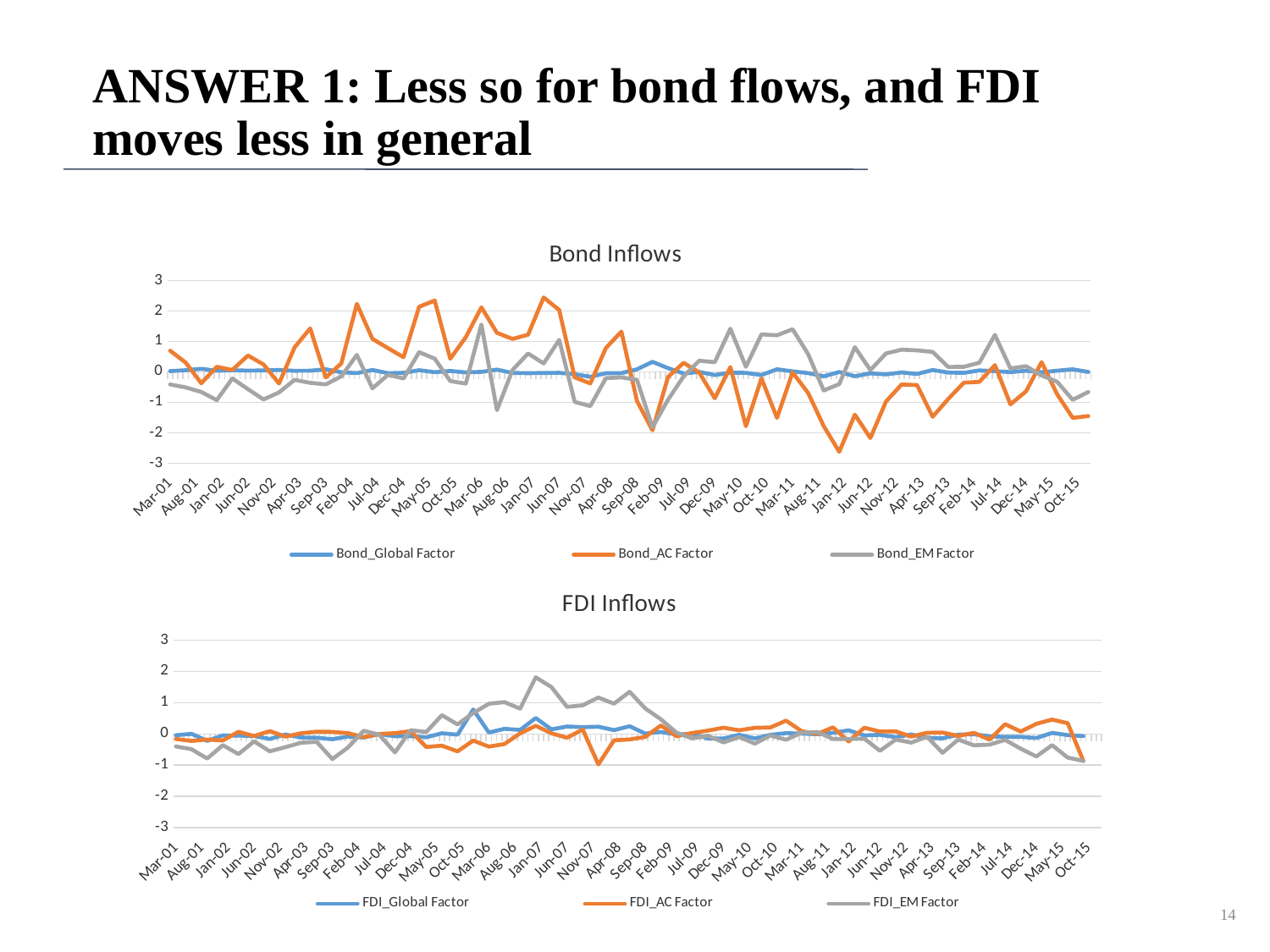
In the Bond Inflows chart, at Jan-12, which is larger: Bond_Global Factor or Bond_AC Factor? Bond_Global Factor In the FDI Inflows chart, is the value of FDI_EM Factor at Jan-07 greater or less than 1? greater In the FDI Inflows chart, which series reaches the highest value anywhere on the chart? FDI_EM Factor How many series does the legend of the FDI Inflows chart list? 3 What is the first date label on the x axis of the FDI Inflows chart? Mar-01 In the Bond Inflows chart, what colour is the Bond_EM Factor line? Grey In the Bond Inflows chart, is the value of Bond_AC Factor at Jan-12 greater or less than -2? less What are the three series named in the legend of the Bond Inflows chart? Bond_Global Factor, Bond_AC Factor, Bond_EM Factor In the Bond Inflows chart, which series reaches the lowest value anywhere on the chart? Bond_AC Factor What type of chart is the Bond Inflows chart? Line chart